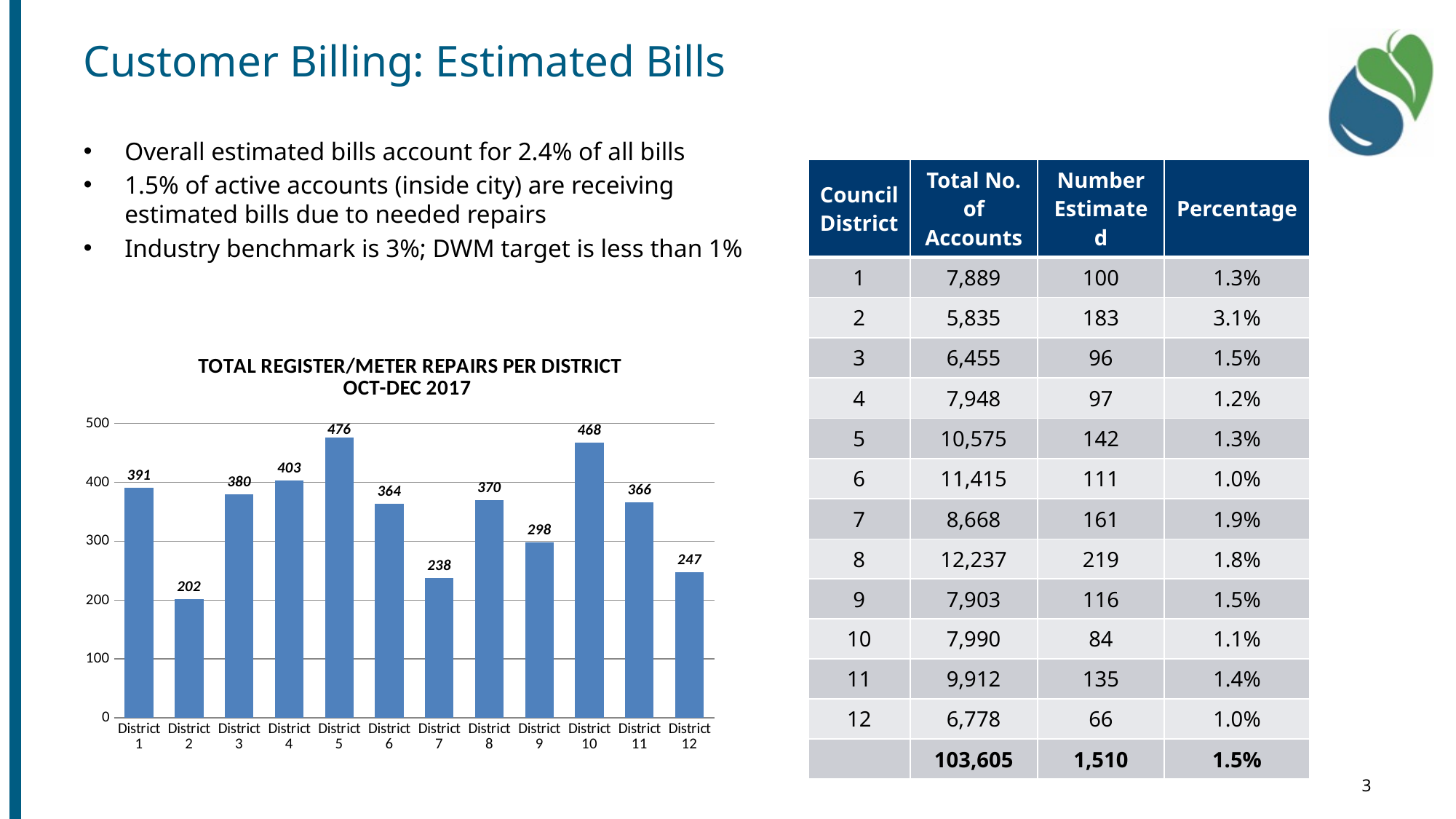
What is the value for District 5 in the chart? 476 What is the highest value shown on the chart's vertical axis? 500 Which district has the lowest number of register/meter repairs in the chart? District 2 What is the value for District 12 in the chart? 247 Which district has the highest number of register/meter repairs in the chart? District 5 Which is larger in the chart, the value for District 1 or the value for District 3? District 1 What is the difference between the values for District 10 and District 7 in the chart? 230 How many districts are shown in the chart? 12 Is the value for District 9 in the chart greater or less than 300? less What is the value for District 2 in the chart? 202 What kind of chart is shown on the slide? bar chart What is the title of the chart? TOTAL REGISTER/METER REPAIRS PER DISTRICT OCT-DEC 2017